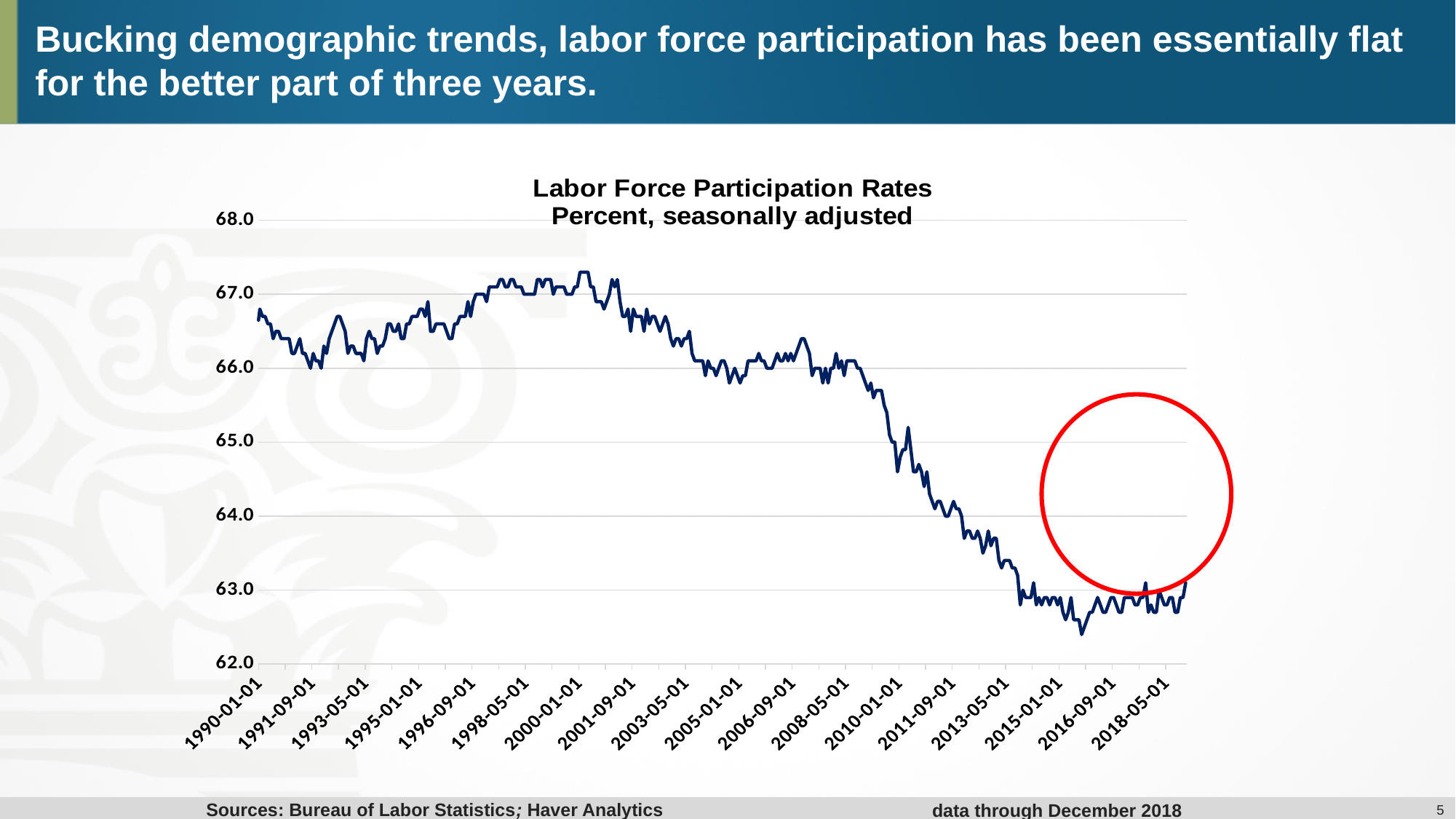
Overall, does the labor force participation rate rise or fall between 2008-05-01 and 2015-01-01? fall Which is larger, the value at 2000-01-01 or the value at 2013-05-01? 2000-01-01 Is the value at 1990-01-01 greater or less than 66.0? greater Is the value at 1998-05-01 greater or less than 66.0? greater Is the value at 2018-05-01 greater or less than 64.0? less What is the title of the chart? Labor Force Participation Rates What kind of chart is shown on the slide? line chart Which is larger, the value at 1990-01-01 or the value at 2018-05-01? 1990-01-01 What is the highest value shown on the chart's y axis? 68.0